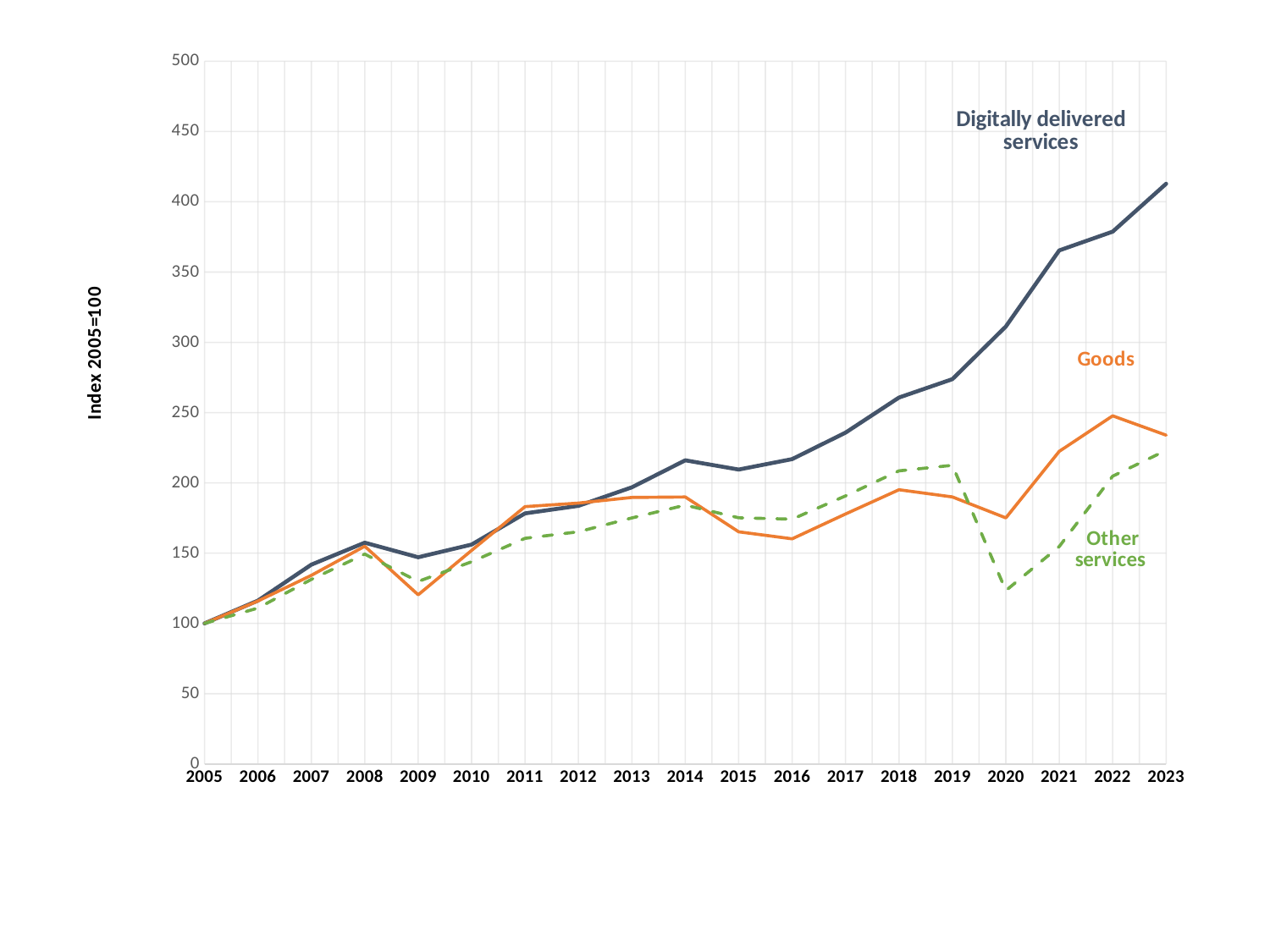
What is the index value for Goods in 2005? 100 Is the value for Other services in 2020 greater or less than 150? less What is the label on the y axis? Index 2005=100 Do the values for Digitally delivered services rise or fall from 2019 to 2023? rise What kind of chart is shown on the slide? line chart How many years are shown along the x axis? 19 In 2022, which is larger: Goods or Other services? Goods Which series has the lowest value in 2020? Other services How many series are plotted on the chart? 3 Which series has the highest value in 2023? Digitally delivered services Is the value for Goods in 2020 greater or less than 200? less Is the value for Digitally delivered services in 2023 greater or less than 400? greater